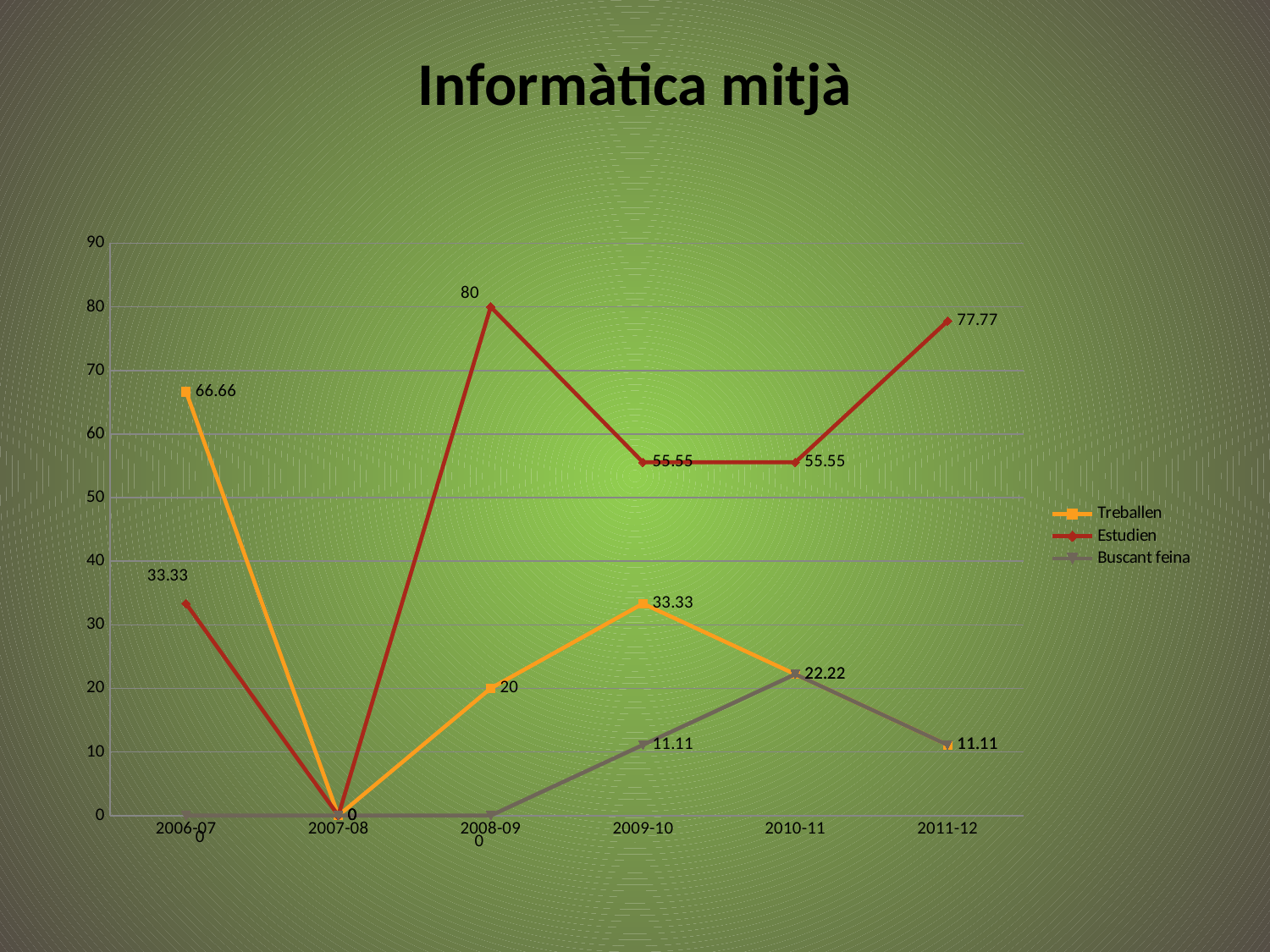
What is the value for Estudien in 2008-09? 80 What is the value for Treballen in 2006-07? 66.66 What is the title of the chart? Informàtica mitjà What is the value for Buscant feina in 2009-10? 11.11 In which year does the Estudien series reach its highest value? 2008-09 In 2006-07, which is larger: Treballen or Estudien? Treballen How many years are shown on the x axis? 6 What is the value for Estudien in 2011-12? 77.77 How many series does the legend list? 3 What is the difference between the Estudien values in 2008-09 and 2009-10? 24.45 What is the value for Treballen in 2008-09? 20 What kind of chart is shown on the slide? line chart